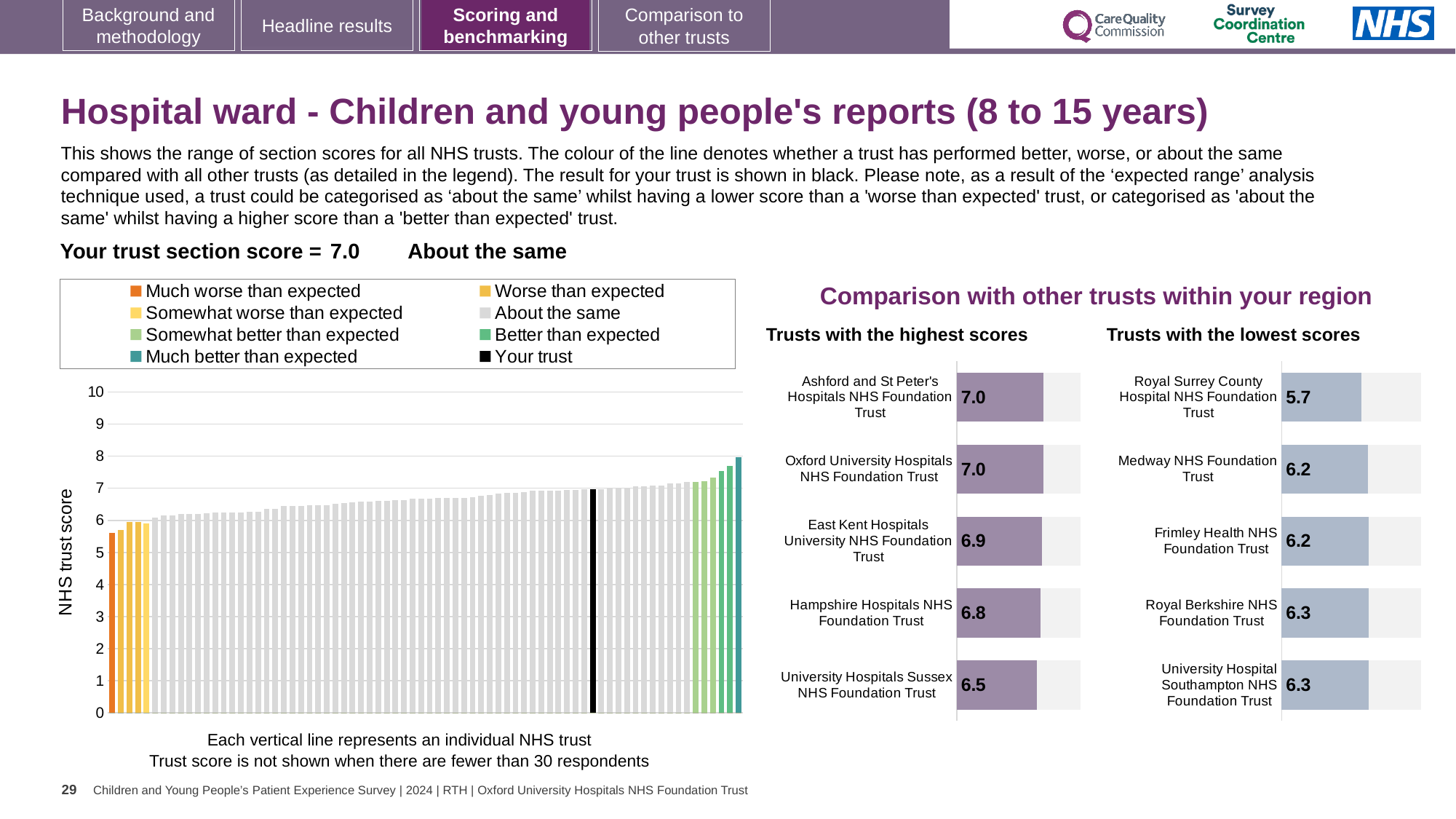
In the 'Trusts with the lowest scores' chart, what is the score for Royal Surrey County Hospital NHS Foundation Trust? 5.7 In the main chart on the left, is the value of the lowest (orange) bar greater or less than 6? less In the 'Trusts with the lowest scores' chart, which trust has the lowest score? Royal Surrey County Hospital NHS Foundation Trust In the 'Trusts with the lowest scores' chart, what is the difference between the scores of Royal Berkshire NHS Foundation Trust and Royal Surrey County Hospital NHS Foundation Trust? 0.6 In the 'Trusts with the highest scores' chart, what is the difference between the scores of Ashford and St Peter's Hospitals NHS Foundation Trust and University Hospitals Sussex NHS Foundation Trust? 0.5 In the 'Trusts with the highest scores' chart, which trust has the lowest score? University Hospitals Sussex NHS Foundation Trust How many trusts are listed in the 'Trusts with the lowest scores' chart? 5 What type of chart is the main chart on the left showing the range of section scores? Bar chart In the 'Trusts with the highest scores' chart, which has the higher score: East Kent Hospitals University NHS Foundation Trust or Hampshire Hospitals NHS Foundation Trust? East Kent Hospitals University NHS Foundation Trust In the 'Trusts with the highest scores' chart, what is the score for University Hospitals Sussex NHS Foundation Trust? 6.5 How many entries does the legend of the main chart on the left list? 8 In the 'Trusts with the highest scores' chart, what is the score for East Kent Hospitals University NHS Foundation Trust? 6.9